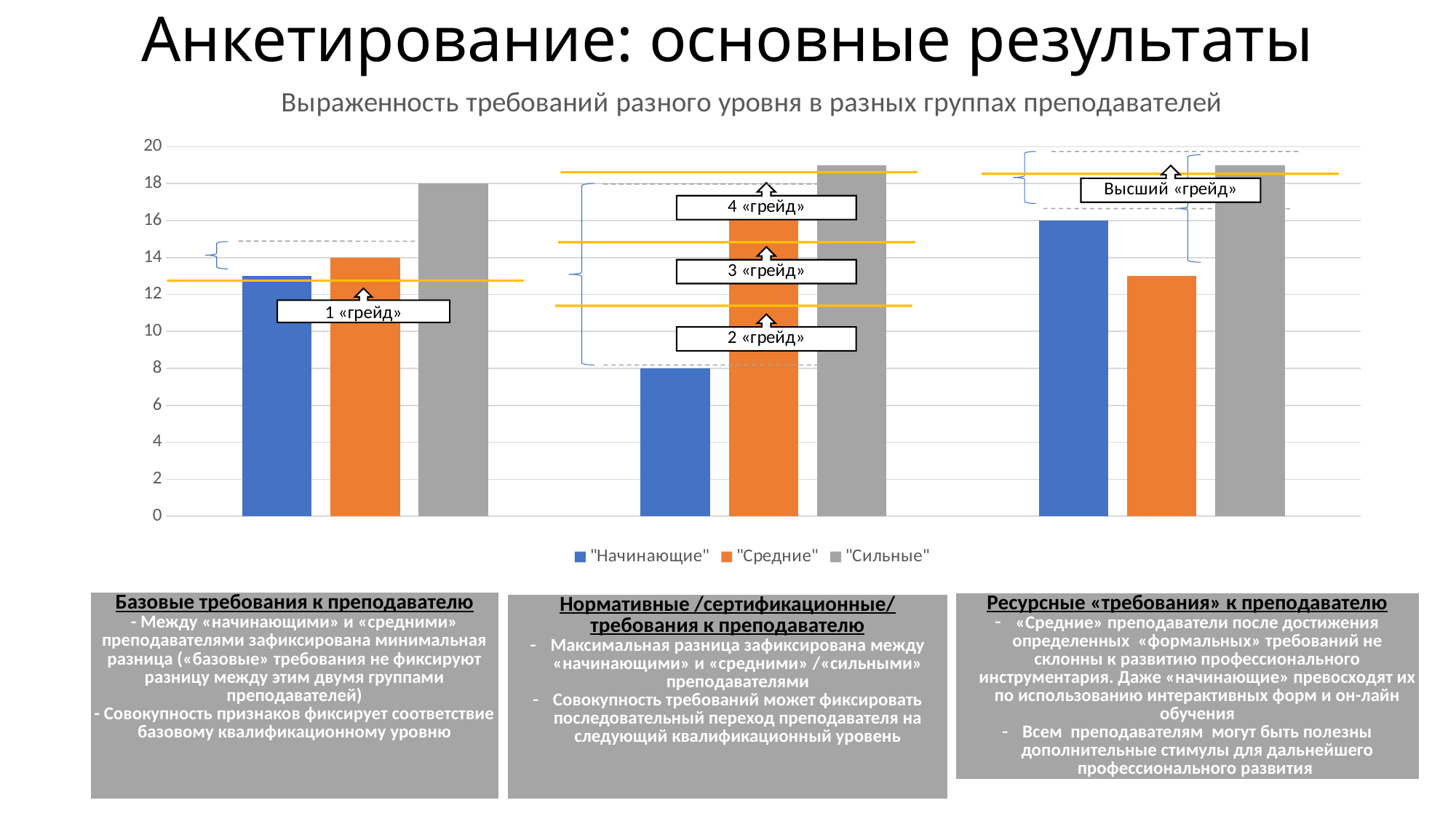
In the middle group, which is larger: the "Начинающие" bar or the "Средние" bar? "Средние" How many groups of bars are plotted on the chart? 3 What is the value of the "Начинающие" bar in the middle group? 8 What is the value of the "Начинающие" bar in the rightmost group? 16 Is the value of the "Начинающие" bar in the leftmost group greater or less than 14? less Which bar is the lowest on the whole chart? "Начинающие" in the middle group What is the title of the chart? Выраженность требований разного уровня в разных группах преподавателей What is the value of the "Сильные" bar in the leftmost group? 18 What is the difference between the "Начинающие" bar in the rightmost group and the "Начинающие" bar in the middle group? 8 How many series does the legend list? 3 What is the value of the "Средние" bar in the leftmost group? 14 What kind of chart is shown on the slide? bar chart